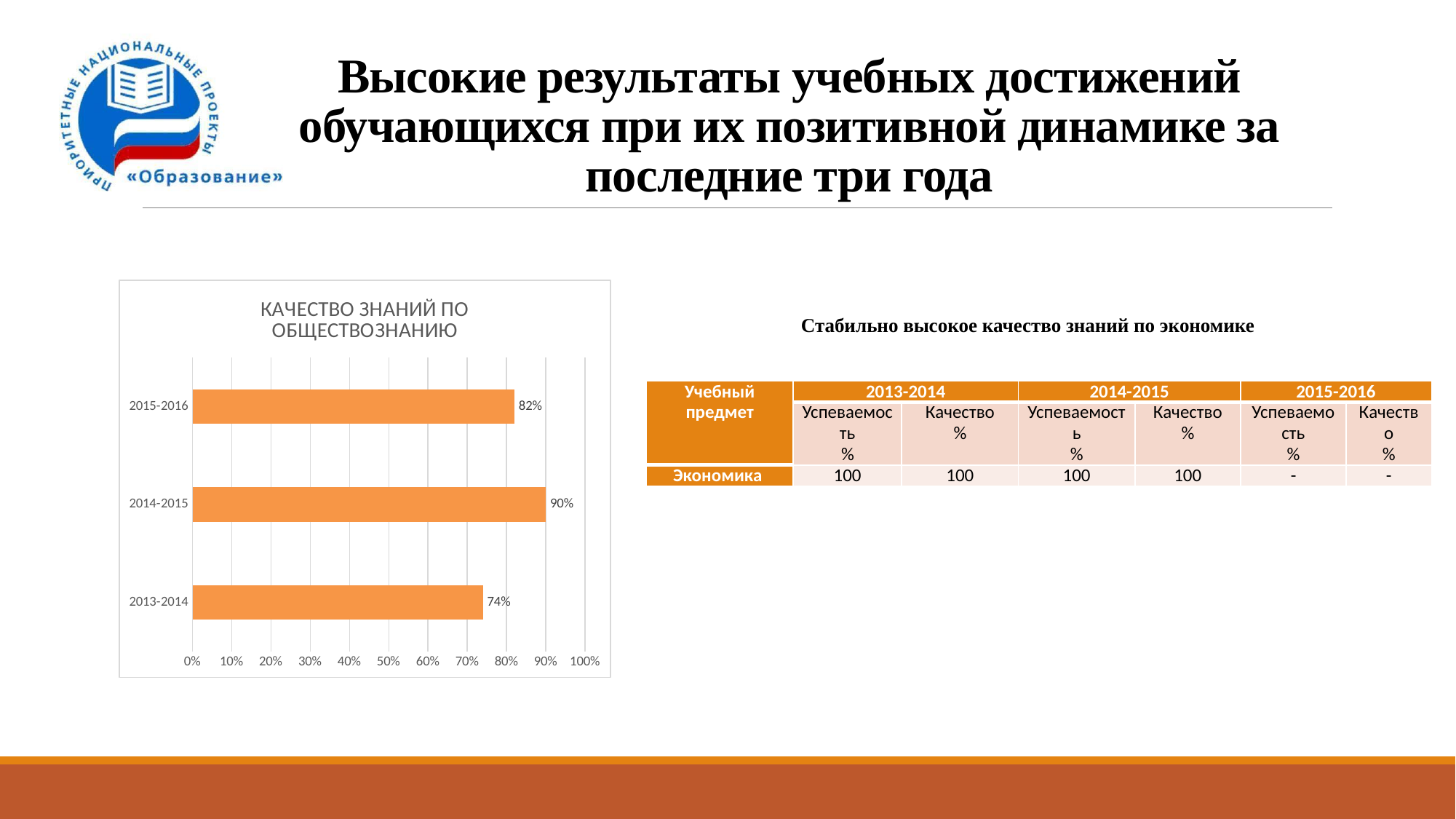
What type of chart is shown on the slide? bar chart Which school year has the highest value in the chart? 2014-2015 What is the value for 2015-2016 in the chart? 82% Did the value rise or fall from 2013-2014 to 2014-2015? rise Which is larger, the value for 2015-2016 or the value for 2013-2014? 2015-2016 What is the value for 2014-2015 in the chart? 90% What is the title of the chart? КАЧЕСТВО ЗНАНИЙ ПО ОБЩЕСТВОЗНАНИЮ What is the value for 2013-2014 in the chart? 74% What is the difference between the values for 2014-2015 and 2013-2014? 16% How many school years are shown in the chart? 3 Which school year has the lowest value in the chart? 2013-2014 What is the difference between the values for 2014-2015 and 2015-2016? 8%